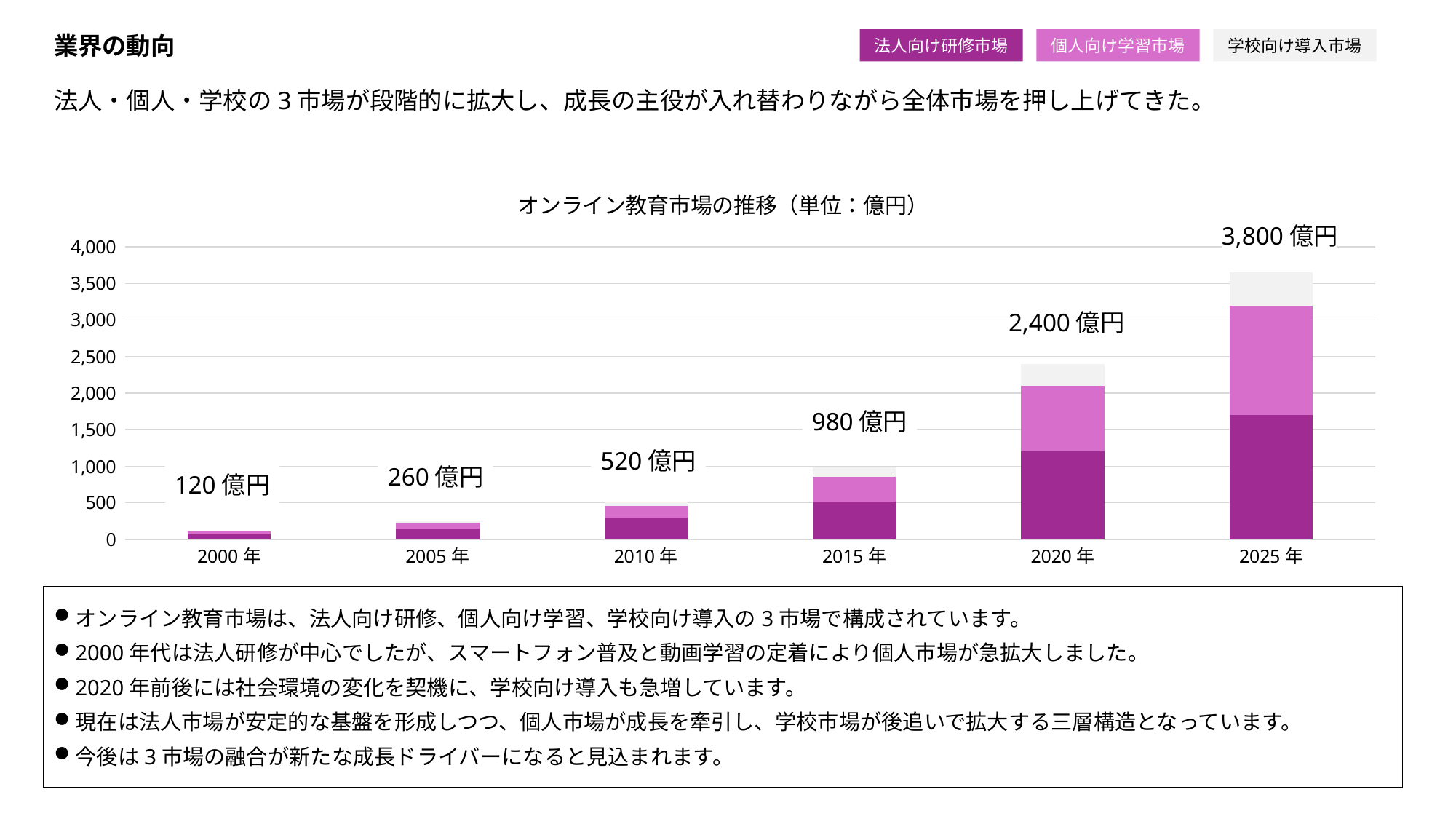
What kind of chart is shown? Stacked bar chart How many years are shown on the x axis? 6 Which year has the lowest total market value? 2000 年 Do the total values rise or fall from 2000年 to 2025年? Rise How many series does the legend list? 3 What is the total value labelled for 2020年? 2,400 億円 What is the difference between the labelled totals for 2015年 and 2010年? 460 億円 What is the total value labelled for 2005年? 260 億円 Which year has the highest total market value? 2025 年 Which is larger, the total for 2010年 or the total for 2015年? 2015 年 Is the 法人向け研修市場 segment for 2025年 greater or less than 1,500? greater What is the difference between the labelled totals for 2025年 and 2020年? 1,400 億円